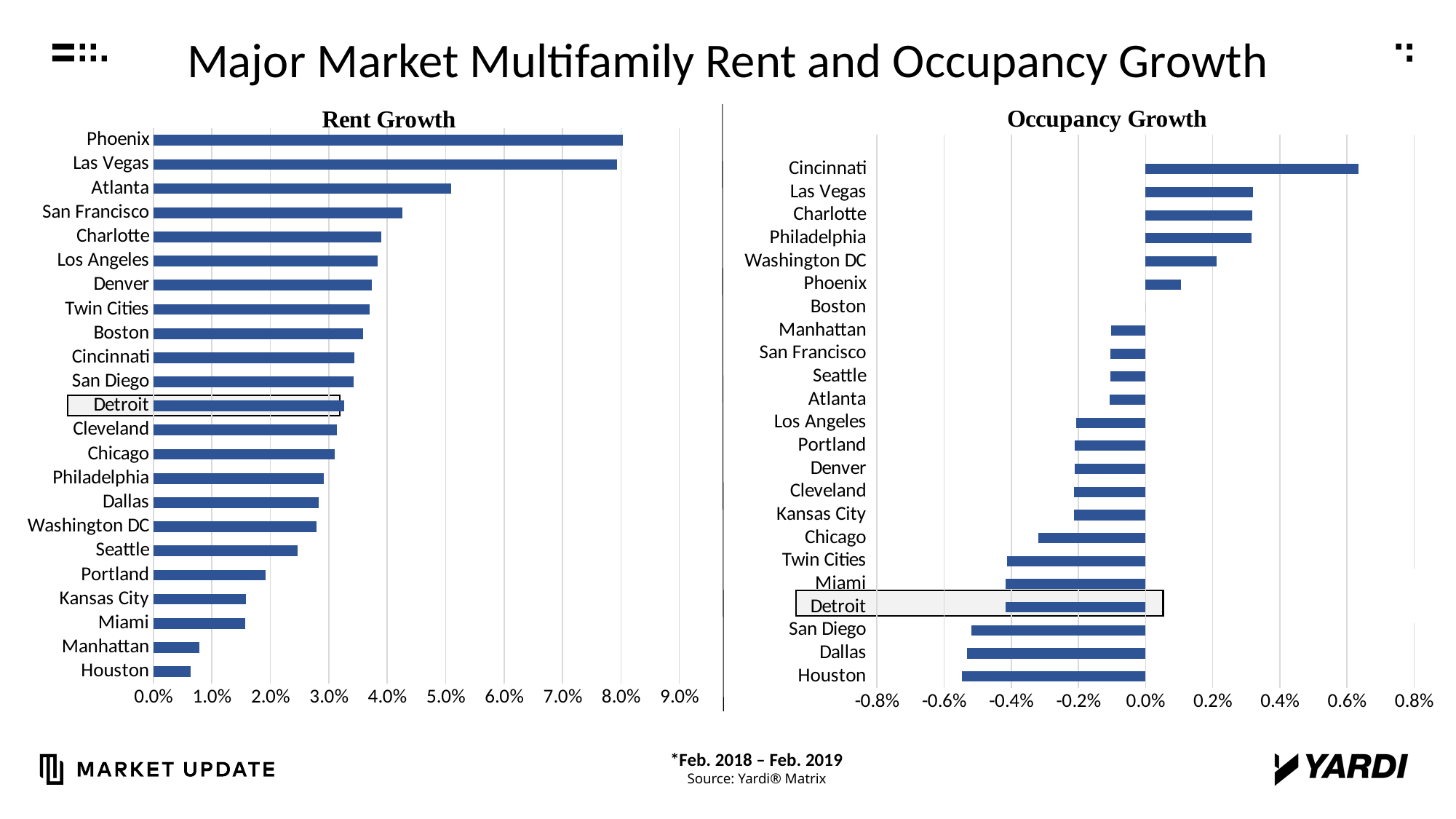
In the Rent Growth chart, which market has the lowest rent growth? Houston In the Rent Growth chart, is the value for Atlanta greater or less than 4.0%? greater In the Rent Growth chart, which market has the highest rent growth? Phoenix How many markets are shown in the Occupancy Growth chart? 23 In the Rent Growth chart, is the value for Manhattan greater or less than 1.0%? less What kind of chart is the Rent Growth chart? bar chart In the Rent Growth chart, which has higher rent growth, Atlanta or Dallas? Atlanta In the Occupancy Growth chart, is the value for Houston greater or less than -0.4%? less In the Occupancy Growth chart, which market has the highest occupancy growth? Cincinnati In the Occupancy Growth chart, which has higher occupancy growth, Las Vegas or Phoenix? Las Vegas Which market is highlighted with a box in both charts? Detroit